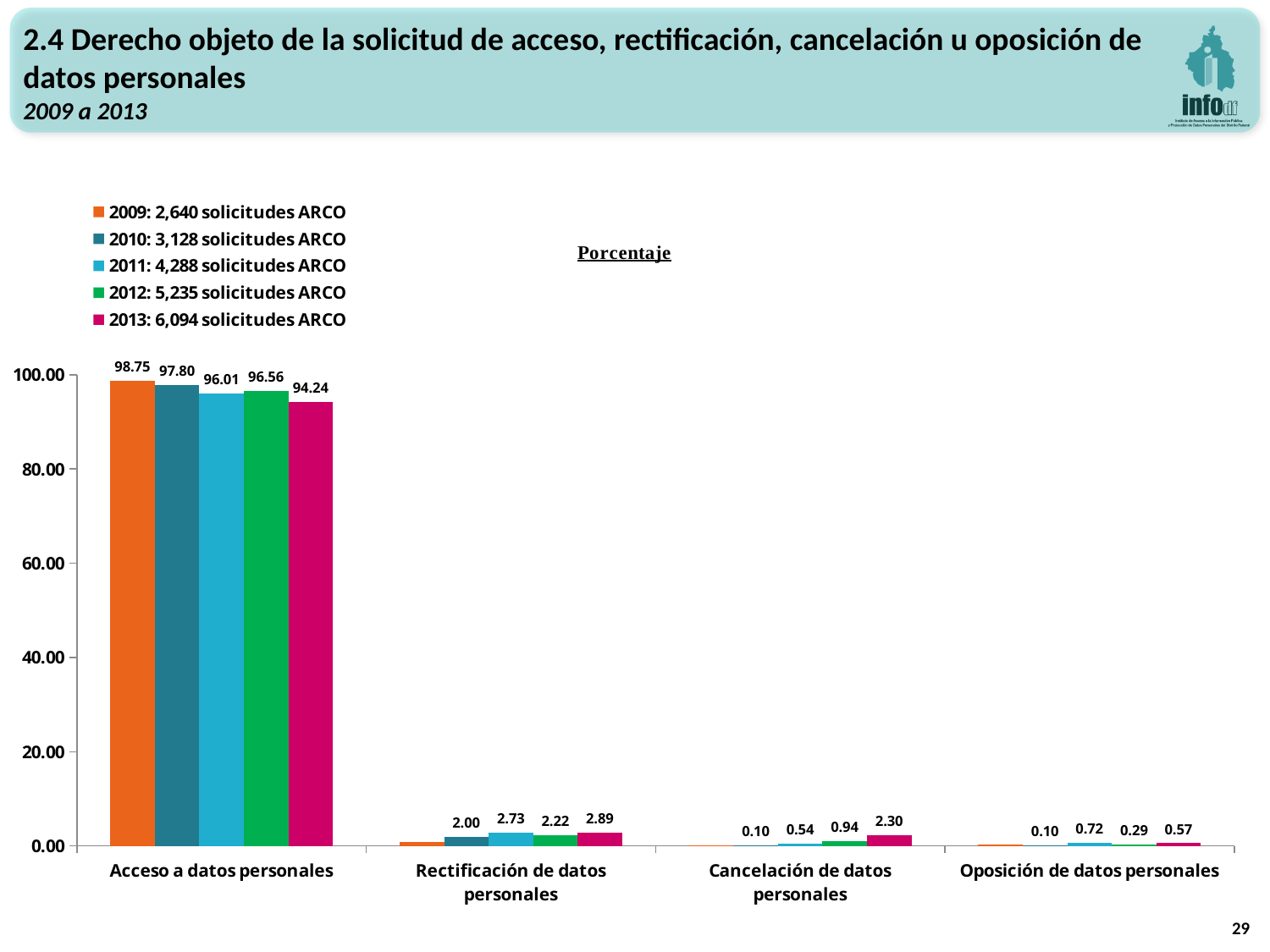
According to the legend, how many solicitudes ARCO were there in 2013? 6,094 What is the percentage for 2013 in the category Rectificación de datos personales? 2.89 What is the difference between the 2009 and 2013 percentages for Acceso a datos personales? 4.51 Which year has the highest percentage for Acceso a datos personales? 2009 Which year has the lowest percentage for Acceso a datos personales? 2013 How many series does the legend list? 5 What kind of chart is shown on the slide? bar chart Is the 2013 value for Acceso a datos personales greater or less than 80.00? greater How many categories are shown on the x axis? 4 What is the percentage for 2013 in the category Acceso a datos personales? 94.24 For Acceso a datos personales, which is larger: the 2011 value or the 2012 value? 2012 What is the percentage for 2009 in the category Acceso a datos personales? 98.75